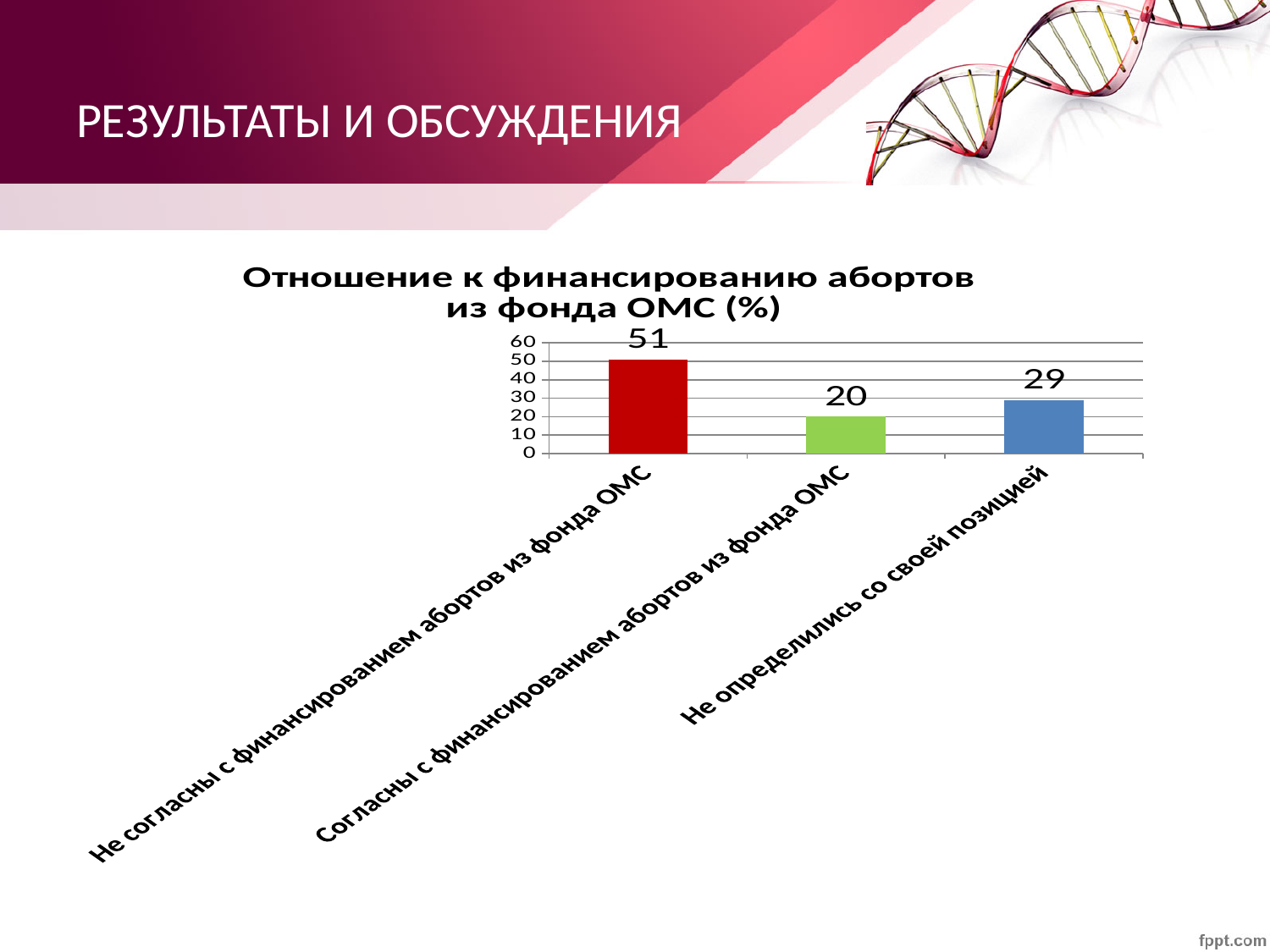
What is the title of the chart? Отношение к финансированию абортов из фонда ОМС (%) What is the value for "Не согласны с финансированием абортов из фонда ОМС"? 51 What is the difference between the values for "Не согласны с финансированием абортов из фонда ОМС" and "Согласны с финансированием абортов из фонда ОМС"? 31 Which category has the lowest value? Согласны с финансированием абортов из фонда ОМС Which is larger: the value for "Не определились со своей позицией" or the value for "Согласны с финансированием абортов из фонда ОМС"? Не определились со своей позицией What is the value for "Не определились со своей позицией"? 29 Which category has the highest value? Не согласны с финансированием абортов из фонда ОМС What is the difference between the values for "Не определились со своей позицией" and "Согласны с финансированием абортов из фонда ОМС"? 9 How many categories are shown in the chart? 3 Is the value for "Не согласны с финансированием абортов из фонда ОМС" greater or less than 40? greater What is the value for "Согласны с финансированием абортов из фонда ОМС"? 20 What kind of chart is shown on the slide? bar chart